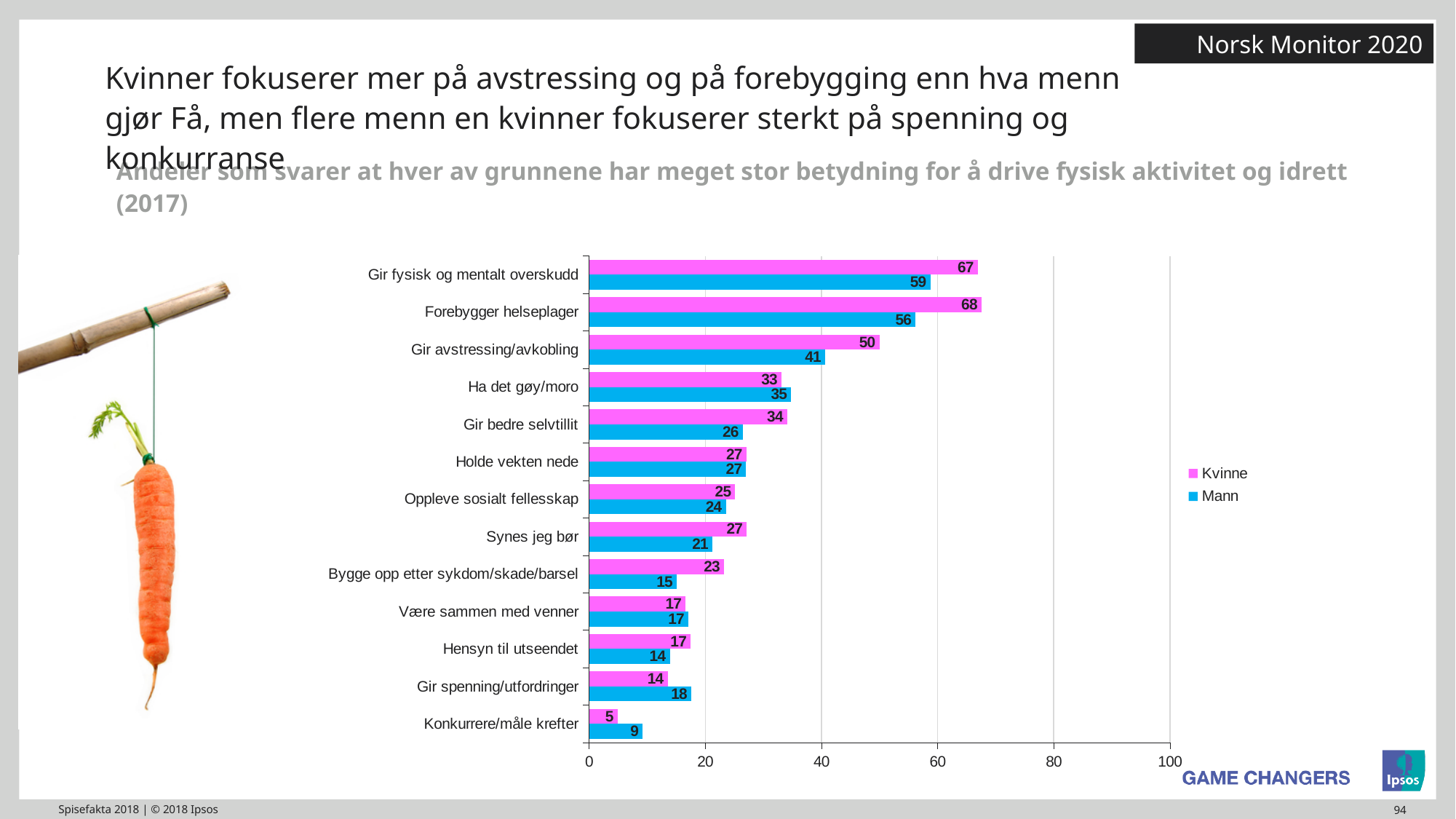
Is the Mann value for "Gir fysisk og mentalt overskudd" greater or less than 40? greater For "Gir spenning/utfordringer", which series has the larger value, Kvinne or Mann? Mann What kind of chart is shown on the slide? bar chart What is the value for Kvinne for "Gir avstressing/avkobling"? 50 What is the value for Mann for "Bygge opp etter sykdom/skade/barsel"? 15 Which category has the lowest Mann value? Konkurrere/måle krefter What is the difference between the Kvinne and Mann values for "Forebygger helseplager"? 12 How many categories are shown on the chart? 13 Which colour represents the Kvinne series in the legend? pink Which category has the highest Kvinne value? Forebygger helseplager What is the value for Mann for "Forebygger helseplager"? 56 How many series does the legend list? 2